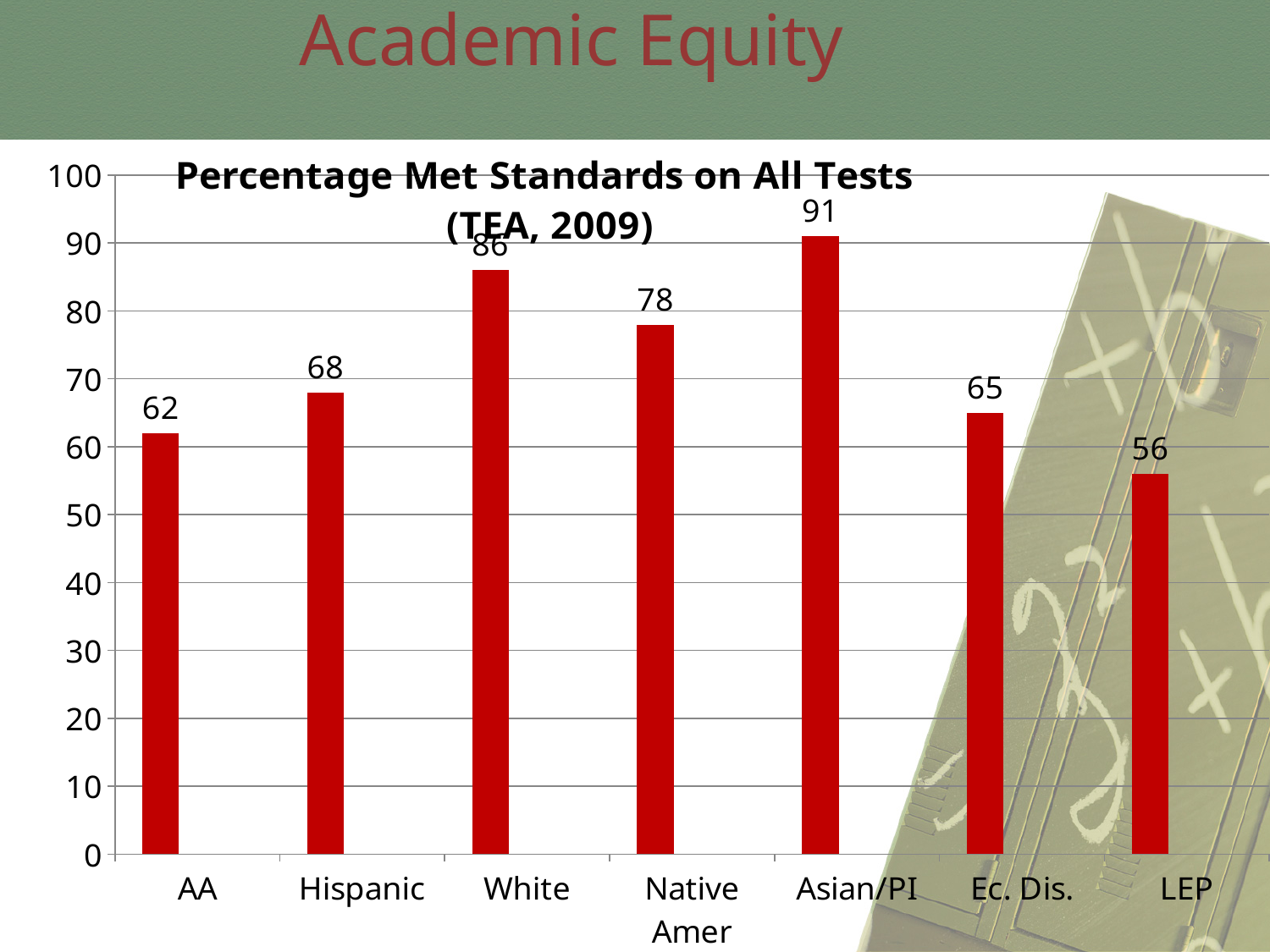
What is the title of the chart? Percentage Met Standards on All Tests (TEA, 2009) How many categories are shown on the x axis? 7 What is the value for Native Amer? 78 Is the value for LEP greater or less than 60? less What is the value for White? 86 Which category has the highest value? Asian/PI Which category has the lowest value? LEP What is the difference between the values for Asian/PI and AA? 29 What kind of chart is shown on the slide? bar chart What is the value for Ec. Dis.? 65 What is the difference between the values for White and Hispanic? 18 Which is larger, the value for Hispanic or the value for Ec. Dis.? Hispanic